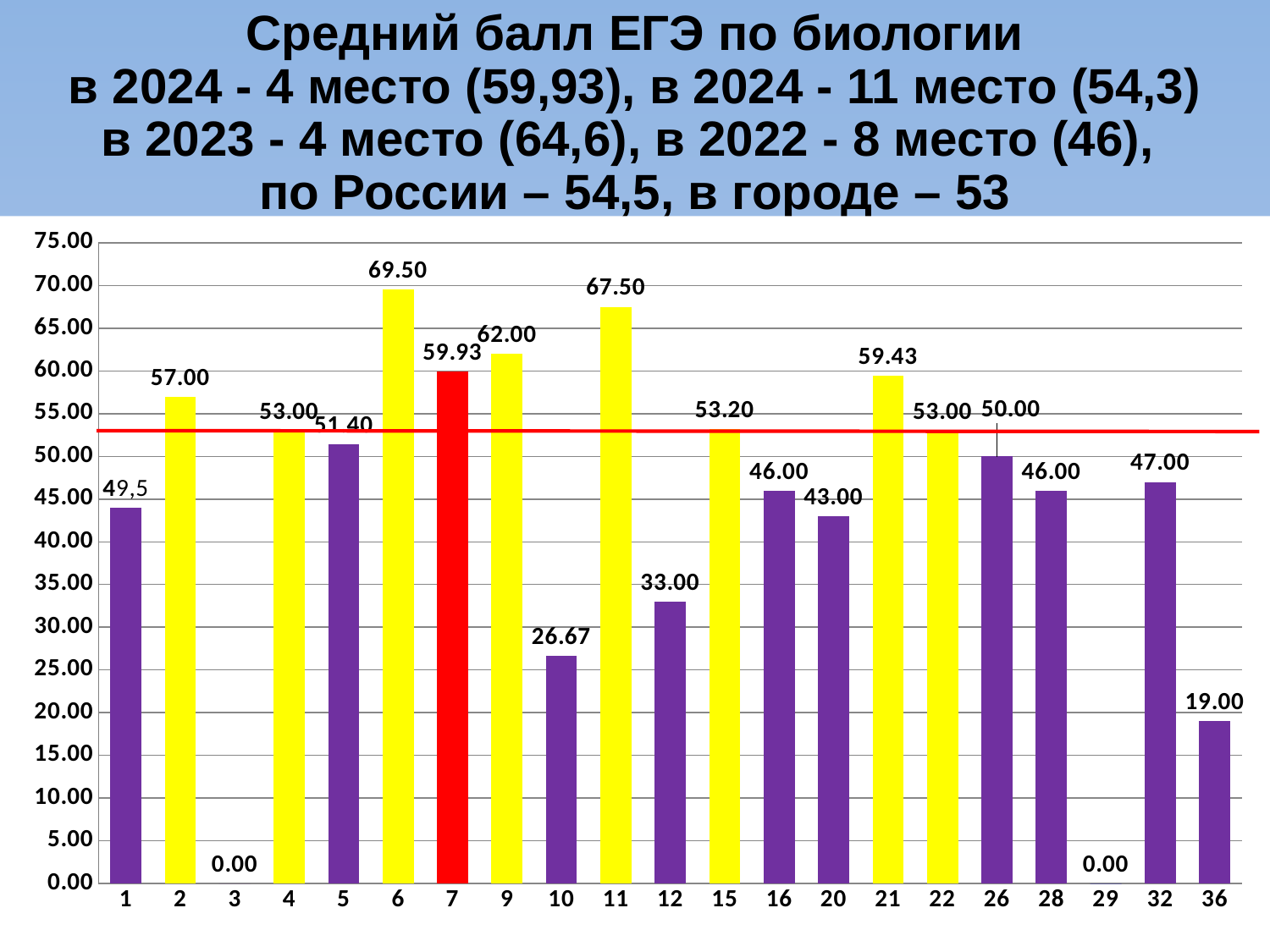
Which category has the highest value? 6 What is the difference between the values for category 6 and category 11? 2.00 Which category has the lowest non-zero value? 36 Which category is drawn as a red bar? 7 What is the difference between the values for category 9 and category 7? 2.07 What is the value for category 10? 26.67 What is the value for category 6? 69.50 What is the value for category 36? 19.00 Which is larger, the value for category 12 or the value for category 20? 20 How many categories are shown on the x axis? 21 What is the value for category 7 (the red bar)? 59.93 What kind of chart is shown on the slide? bar chart